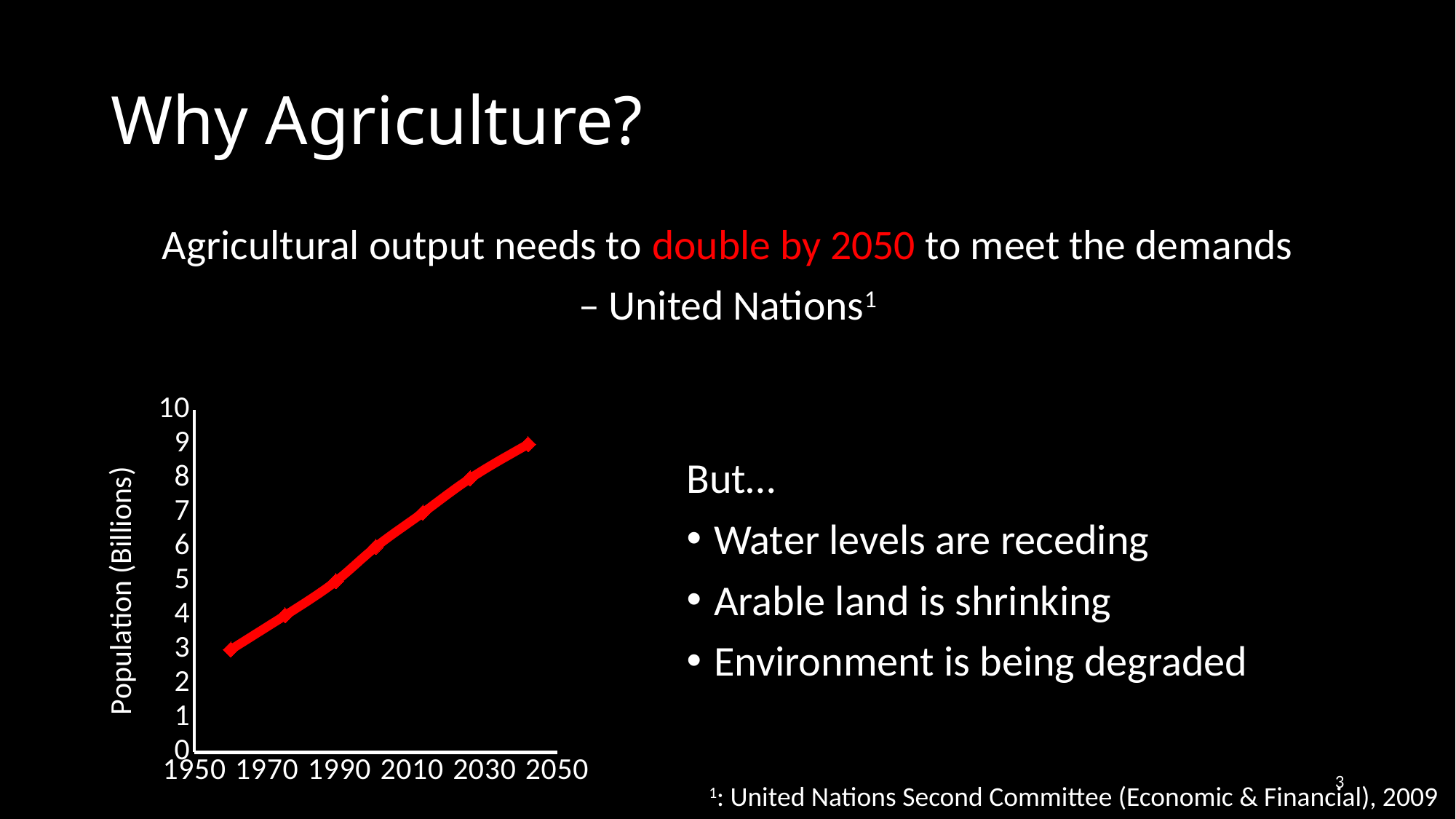
Which is larger, the population value at 2030 or at 1970? 2030 Is the lowest value on the population line greater or less than 4? less Is the population value at 1990 greater or less than 4? greater Is the population value at 1970 greater or less than 5? less How many lines are plotted on the chart? 1 What colour is the line plotted on the chart? red At which end of the x axis, 1950 or 2050, does the line reach its highest value? 2050 Does the population line rise or fall from 1950 toward 2050? rise What kind of chart is shown on the slide? line chart What is the label of the vertical axis of the chart? Population (Billions)